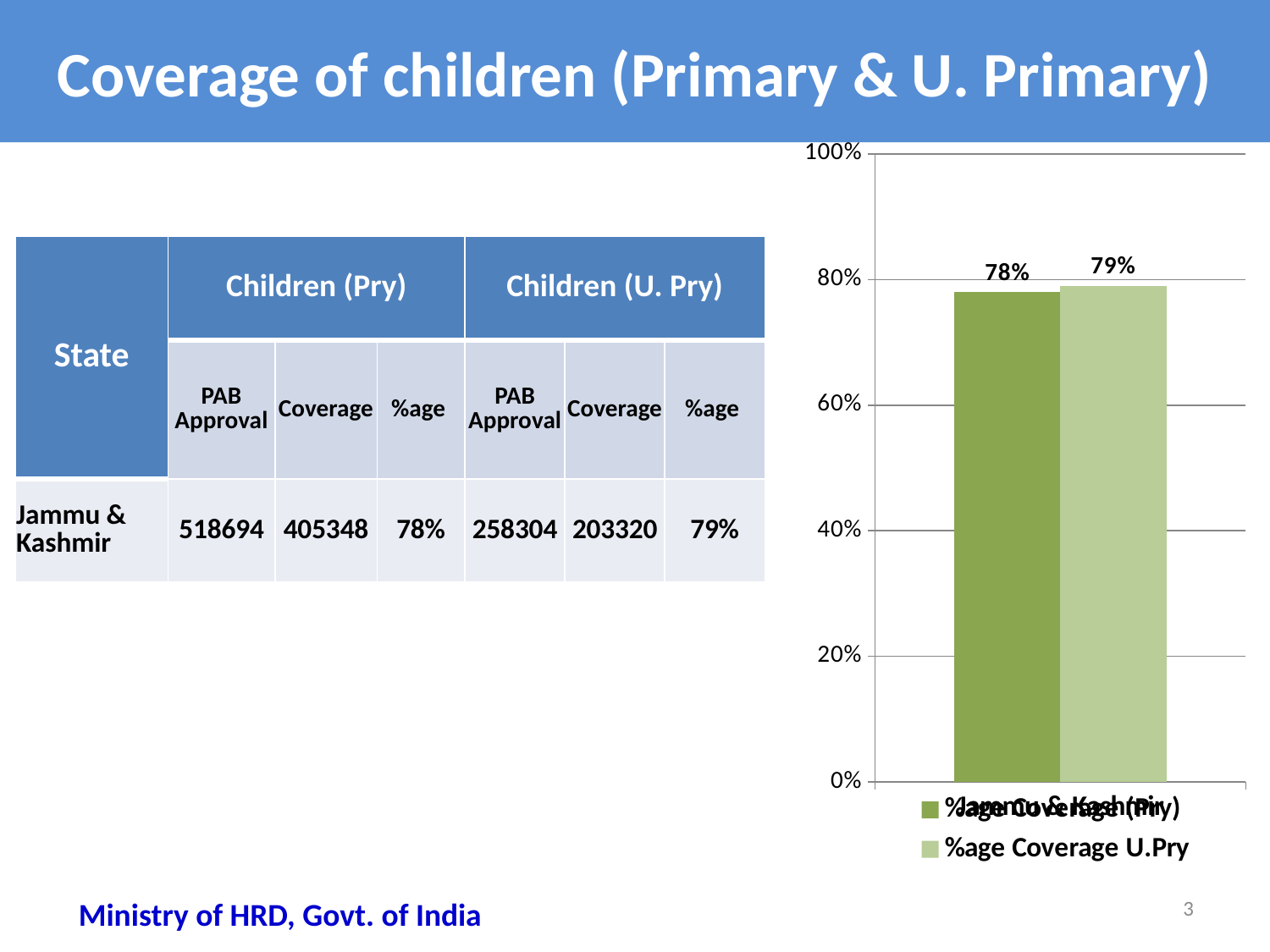
Which series has the higher value in the chart, %age Coverage (Pry) or %age Coverage U.Pry? %age Coverage U.Pry Which series in the chart is drawn in the darker green colour? %age Coverage (Pry) How many bars are plotted in the chart? 2 Is the value of the %age Coverage U.Pry bar greater or less than 60%? greater What is the value of the %age Coverage U.Pry bar in the chart? 79% What is the difference between the %age Coverage U.Pry value and the %age Coverage (Pry) value in the chart? 1% What is the value of the %age Coverage (Pry) bar in the chart? 78% What is the highest value shown on the chart's vertical axis? 100% How many series does the chart legend list? 2 What kind of chart is shown on the slide? bar chart Is the value of the %age Coverage (Pry) bar greater or less than 80%? less